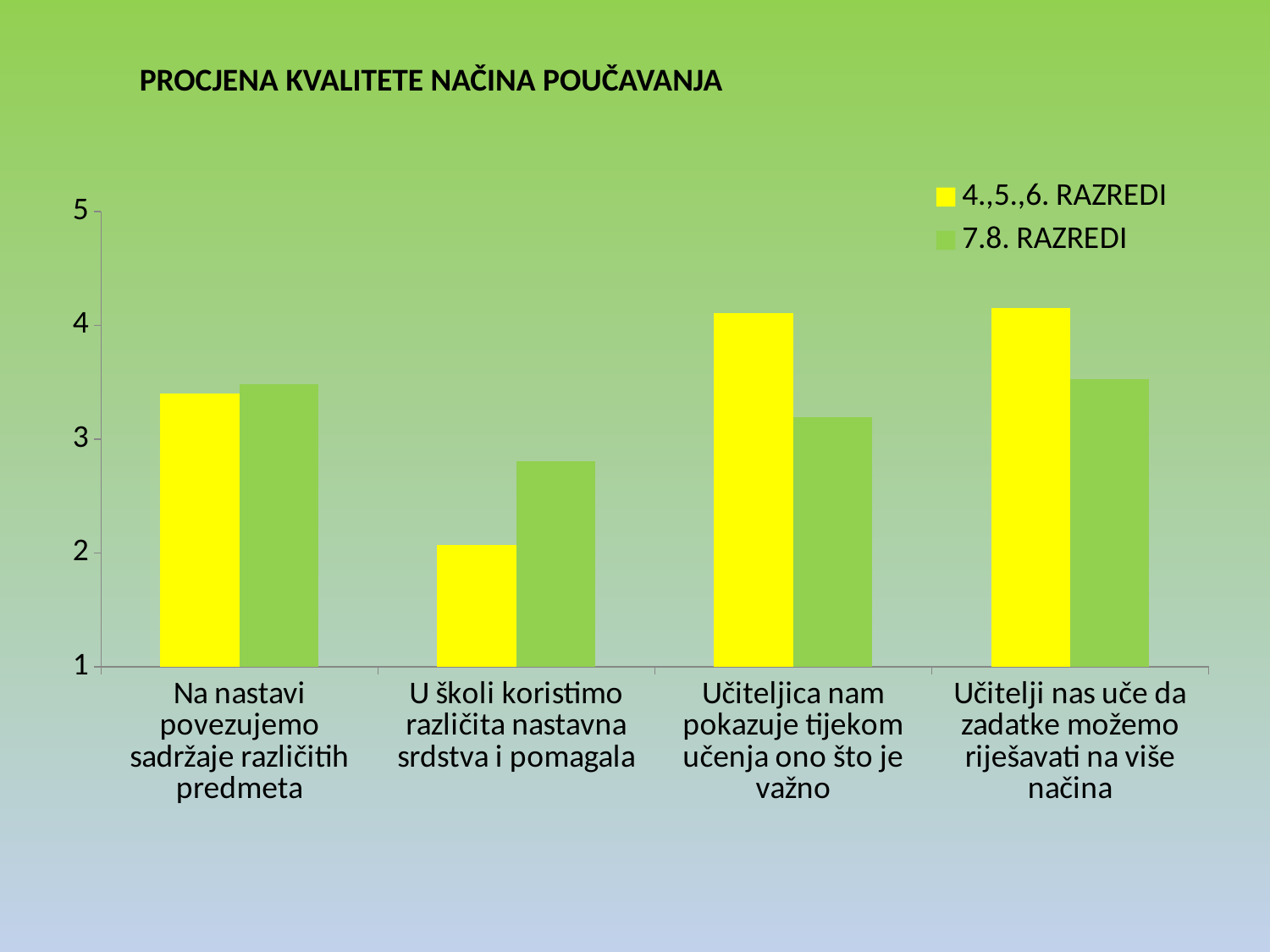
How many series does the legend list? 2 Which category has the lowest value for the 4.,5.,6. RAZREDI series? U školi koristimo različita nastavna srdstva i pomagala Which category has the lowest value for the 7.8. RAZREDI series? U školi koristimo različita nastavna srdstva i pomagala Which series is shown in yellow in the legend? 4.,5.,6. RAZREDI What is the title of the chart? PROCJENA KVALITETE NAČINA POUČAVANJA What kind of chart is shown on the slide? bar chart How many categories are shown on the x axis of the chart? 4 Is the value for 7.8. RAZREDI in 'Učitelji nas uče da zadatke možemo riješavati na više načina' greater or less than 4? less Is the value for 4.,5.,6. RAZREDI in 'Učiteljica nam pokazuje tijekom učenja ono što je važno' greater or less than 4? greater For 'U školi koristimo različita nastavna srdstva i pomagala', which series has the larger value, 4.,5.,6. RAZREDI or 7.8. RAZREDI? 7.8. RAZREDI Is the value for 7.8. RAZREDI in 'U školi koristimo različita nastavna srdstva i pomagala' greater or less than 3? less For 'Učiteljica nam pokazuje tijekom učenja ono što je važno', which series has the larger value, 4.,5.,6. RAZREDI or 7.8. RAZREDI? 4.,5.,6. RAZREDI